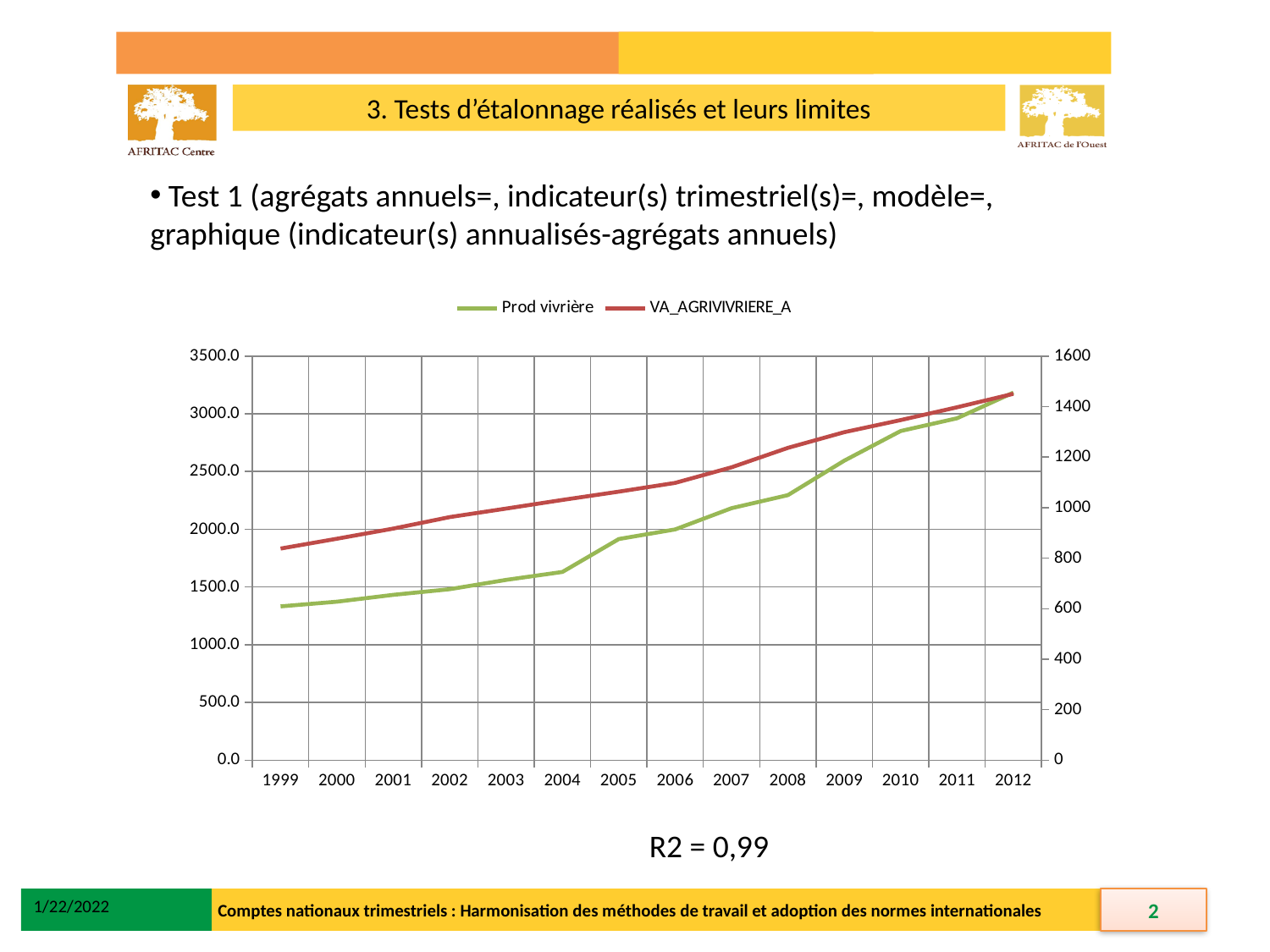
What is the first year shown on the x axis of the chart? 1999 How many series does the chart legend list? 2 Does the VA_AGRIVIVRIERE_A line rise or fall from 1999 to 2012? rise In which year is the Prod vivrière series at its lowest? 1999 How many years are plotted along the x axis of the chart? 14 What kind of chart is shown on the slide? line chart In which year is the VA_AGRIVIVRIERE_A series at its highest? 2012 What is the last year shown on the x axis of the chart? 2012 In which year is the Prod vivrière series at its highest? 2012 In which year is the VA_AGRIVIVRIERE_A series at its lowest? 1999 Does the Prod vivrière line rise or fall from 1999 to 2012? rise